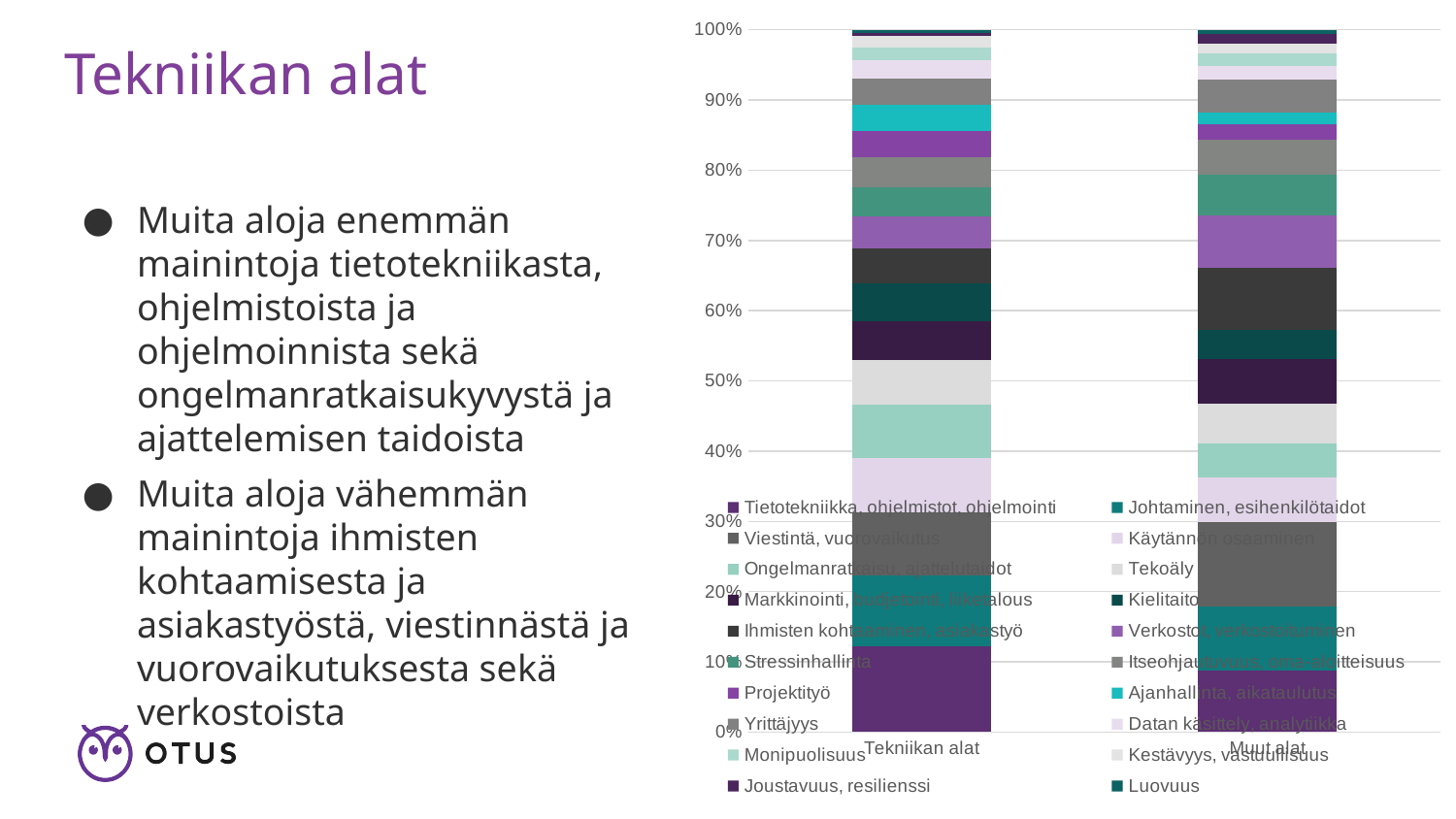
What is the maximum value shown on the chart's y axis? 100% How many categories are shown on the x axis of the chart? 2 What are the two categories on the x axis of the chart? Tekniikan alat and Muut alat What kind of chart is shown on the slide? stacked bar chart What is the total height of each stacked bar in the chart? 100% Is the share of Tietotekniikka, ohjelmistot, ohjelmointi for Tekniikan alat greater or less than 10%? greater Which category has the larger share for Tietotekniikka, ohjelmistot, ohjelmointi: Tekniikan alat or Muut alat? Tekniikan alat Is the share of Tietotekniikka, ohjelmistot, ohjelmointi for Muut alat greater or less than 10%? less How many series does the chart's legend list? 20 What is the first series listed in the chart's legend? Tietotekniikka, ohjelmistot, ohjelmointi Which category has the larger share for Viestintä, vuorovaikutus: Tekniikan alat or Muut alat? Muut alat